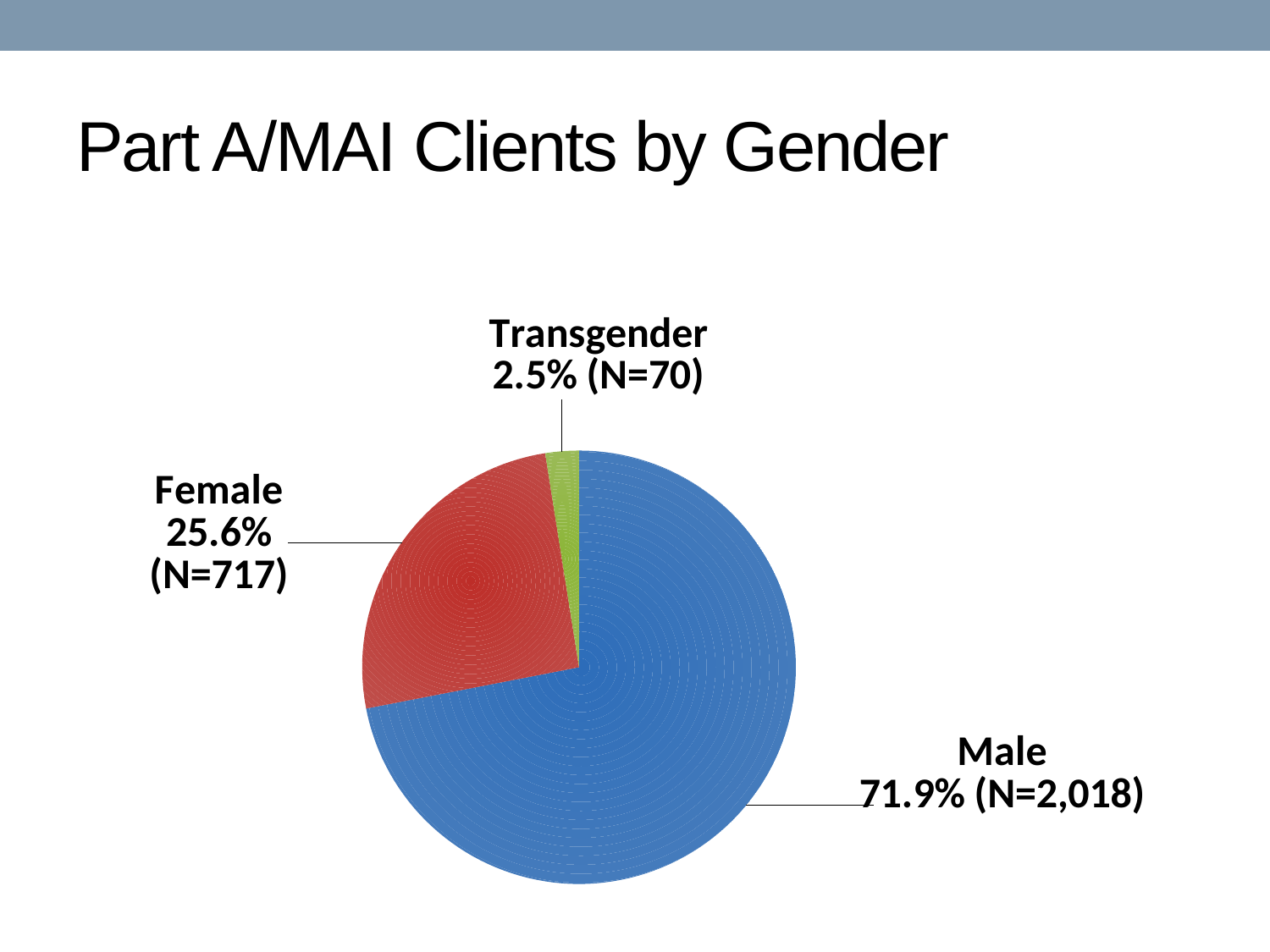
What is the difference in percentage points between the Male and Female shares? 46.3 Which is larger, the Female share or the Transgender share? Female What is the N value shown for Male clients? 2,018 What colour is the Female slice of the pie? Red How many more Female clients are there than Transgender clients? 647 What percentage of Part A/MAI clients are Female? 25.6% What type of chart is shown on the slide? Pie chart What is the N value shown for Transgender clients? 70 What percentage of Part A/MAI clients are Male? 71.9% Which gender category has the largest share of the pie? Male Which gender category has the smallest share of the pie? Transgender How many gender categories are shown in the pie chart? 3